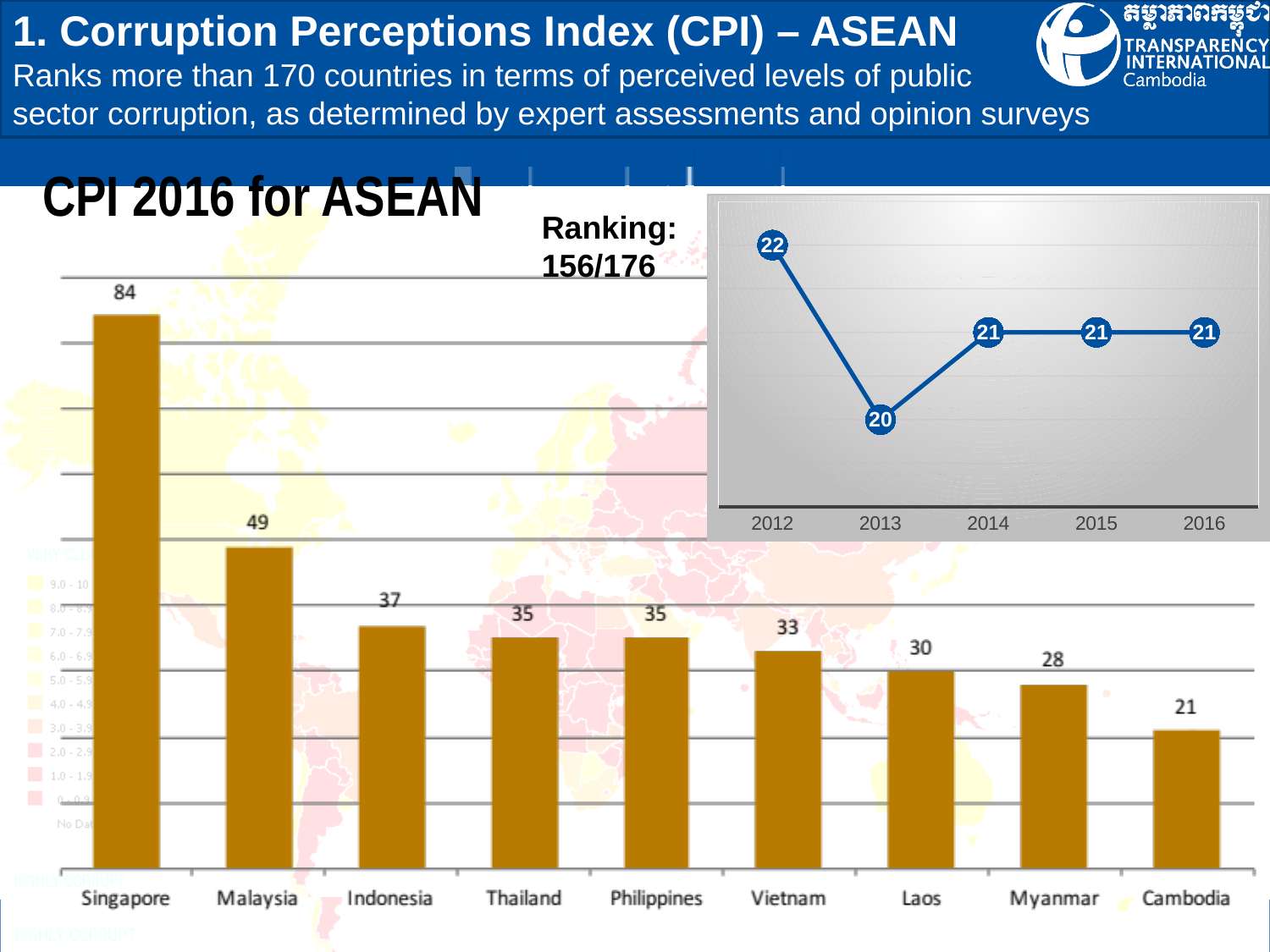
In the line chart at the top right, what is the value for 2013? 20 In the CPI 2016 for ASEAN bar chart, what is the value for Cambodia? 21 How many countries are shown in the CPI 2016 for ASEAN bar chart? 9 How many years are plotted in the line chart at the top right? 5 In the CPI 2016 for ASEAN bar chart, which country has the lowest value? Cambodia In the line chart at the top right, what is the value for 2012? 22 In the CPI 2016 for ASEAN bar chart, what is the value for Singapore? 84 In the line chart at the top right, which year has the lowest value? 2013 What kind of chart is the CPI 2016 for ASEAN chart? bar chart In the CPI 2016 for ASEAN bar chart, which country has the highest value? Singapore In the CPI 2016 for ASEAN bar chart, which is larger, the value for Vietnam or the value for Laos? Vietnam In the CPI 2016 for ASEAN bar chart, what is the difference between Singapore and Malaysia? 35